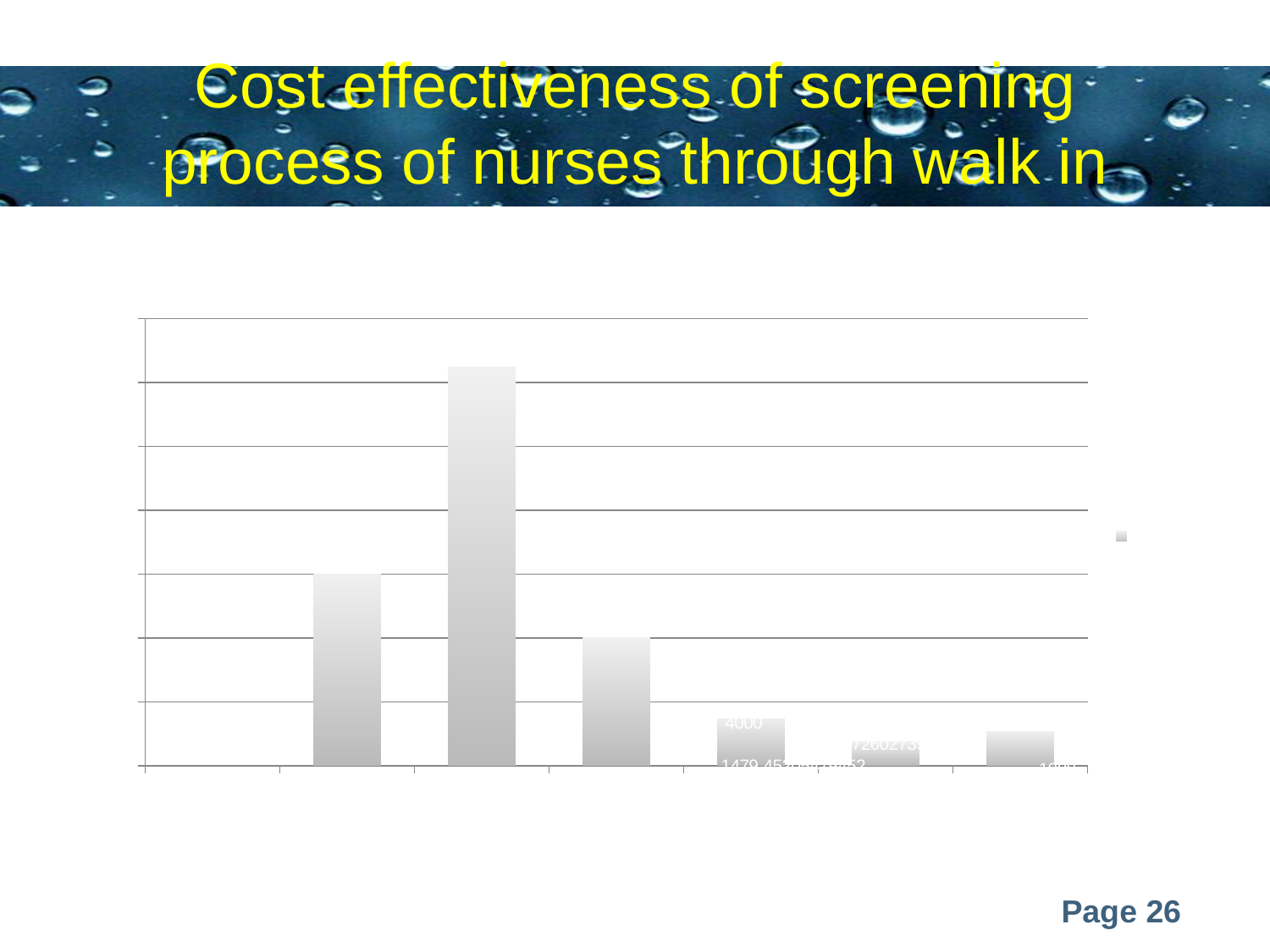
Counting visible bars from the left, is the third bar or the sixth bar taller? the third bar How many bars are visible in the chart? 6 Which bar in the chart is the tallest, counting visible bars from the left? the second bar Which bar in the chart is the shortest, counting visible bars from the left? the fifth bar Counting visible bars from the left, is the first bar or the third bar taller? the first bar What is the title of the slide containing the chart? Cost effectiveness of screening process of nurses through walk in Are the bars in the chart vertical or horizontal? vertical What kind of chart is shown on the slide? bar chart Counting visible bars from the left, is the second bar or the fourth bar taller? the second bar